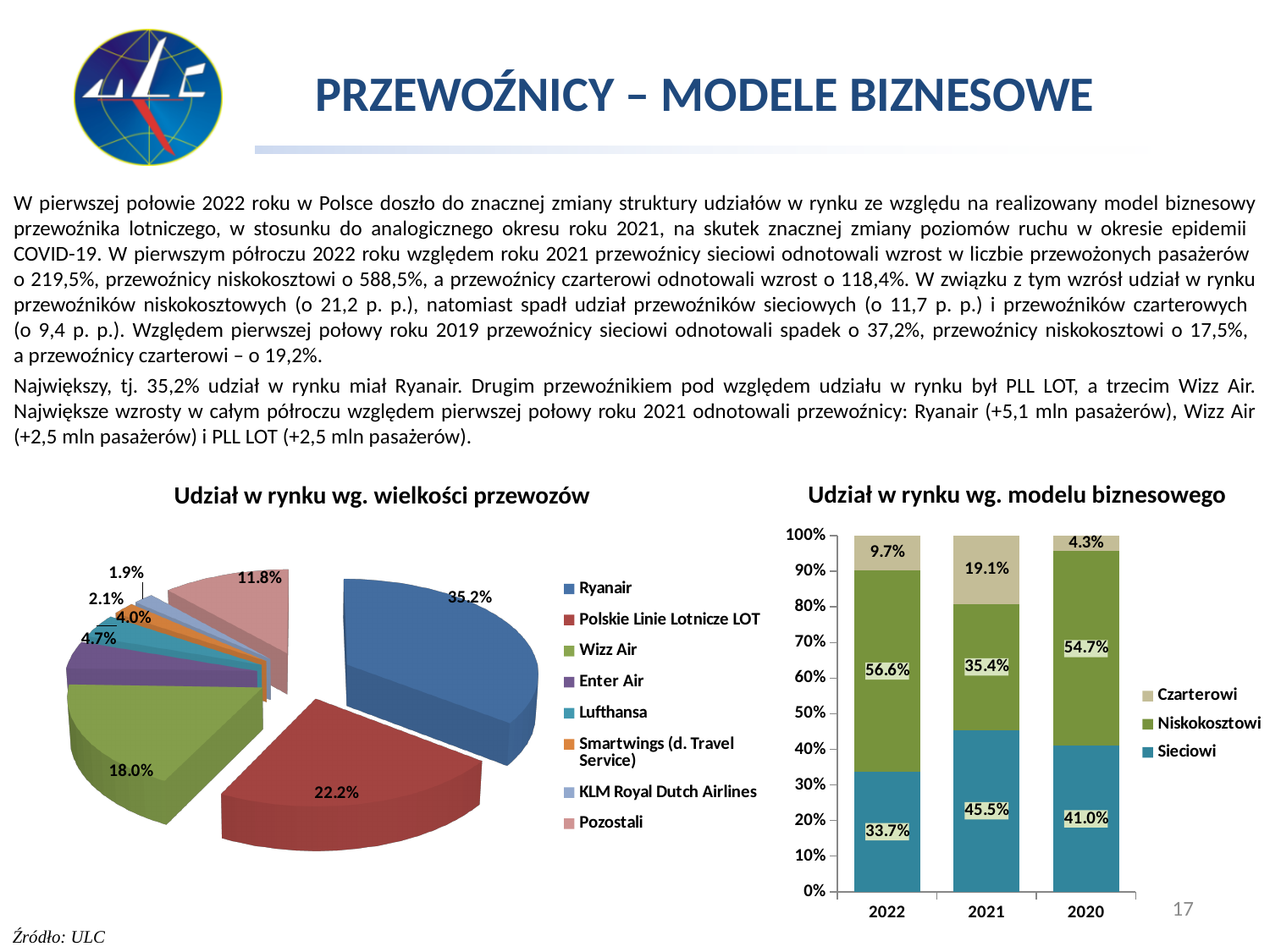
In the chart 'Udział w rynku wg. modelu biznesowego', is the share of Niskokosztowi larger in 2020 or in 2021? 2020 What type of chart is 'Udział w rynku wg. modelu biznesowego'? Stacked bar chart In the chart 'Udział w rynku wg. modelu biznesowego', what is the share of Niskokosztowi in 2022? 56.6% In the chart 'Udział w rynku wg. modelu biznesowego', which year has the highest share of Sieciowi? 2021 In the pie chart 'Udział w rynku wg. wielkości przewozów', what is the market share of Ryanair? 35.2% In the pie chart 'Udział w rynku wg. wielkości przewozów', how many slices are listed in the legend? 8 In the chart 'Udział w rynku wg. modelu biznesowego', how many series does the legend list? 3 In the chart 'Udział w rynku wg. modelu biznesowego', what is the share of Czarterowi in 2021? 19.1% In the pie chart 'Udział w rynku wg. wielkości przewozów', which carrier has the largest share? Ryanair In the pie chart 'Udział w rynku wg. wielkości przewozów', what is the difference between the shares of Ryanair and Wizz Air? 17.2 percentage points In the pie chart 'Udział w rynku wg. wielkości przewozów', what is the share of Polskie Linie Lotnicze LOT? 22.2% In the pie chart 'Udział w rynku wg. wielkości przewozów', what is the share of Pozostali? 11.8%